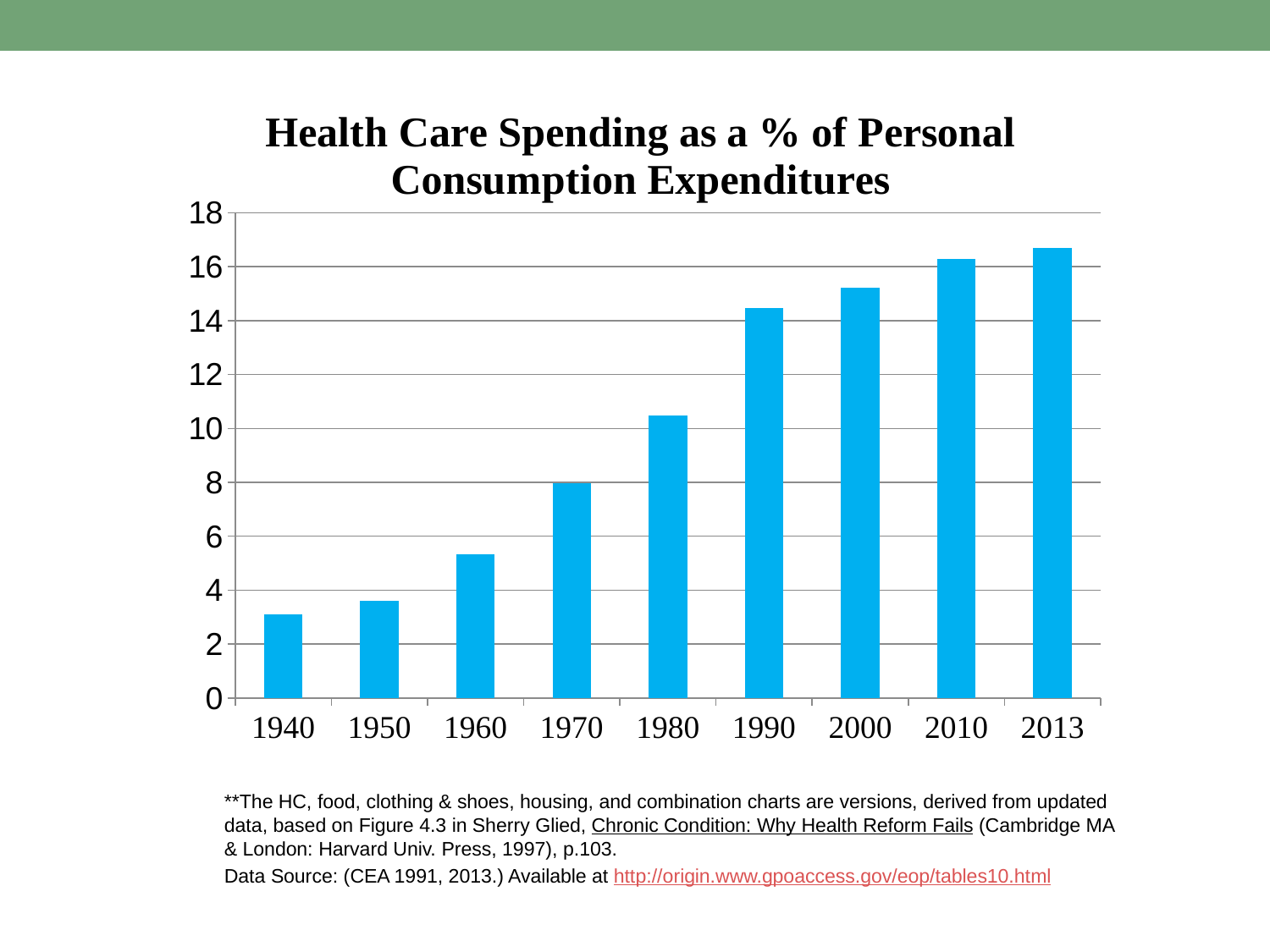
Which is larger, the value for 1950 or the value for 1970? 1970 What kind of chart is shown on the slide? Bar chart How many years are shown on the x axis of the chart? 9 Which year has the highest value? 2013 Is the value for 1960 greater or less than 4? greater Is the value for 2000 greater or less than 16? less Is the value for 1980 greater or less than 10? greater What is the title of the chart? Health Care Spending as a % of Personal Consumption Expenditures Which is larger, the value for 1980 or the value for 1990? 1990 Which year has the lowest value? 1940 Do the values generally rise or fall from 1940 to 2013? Rise